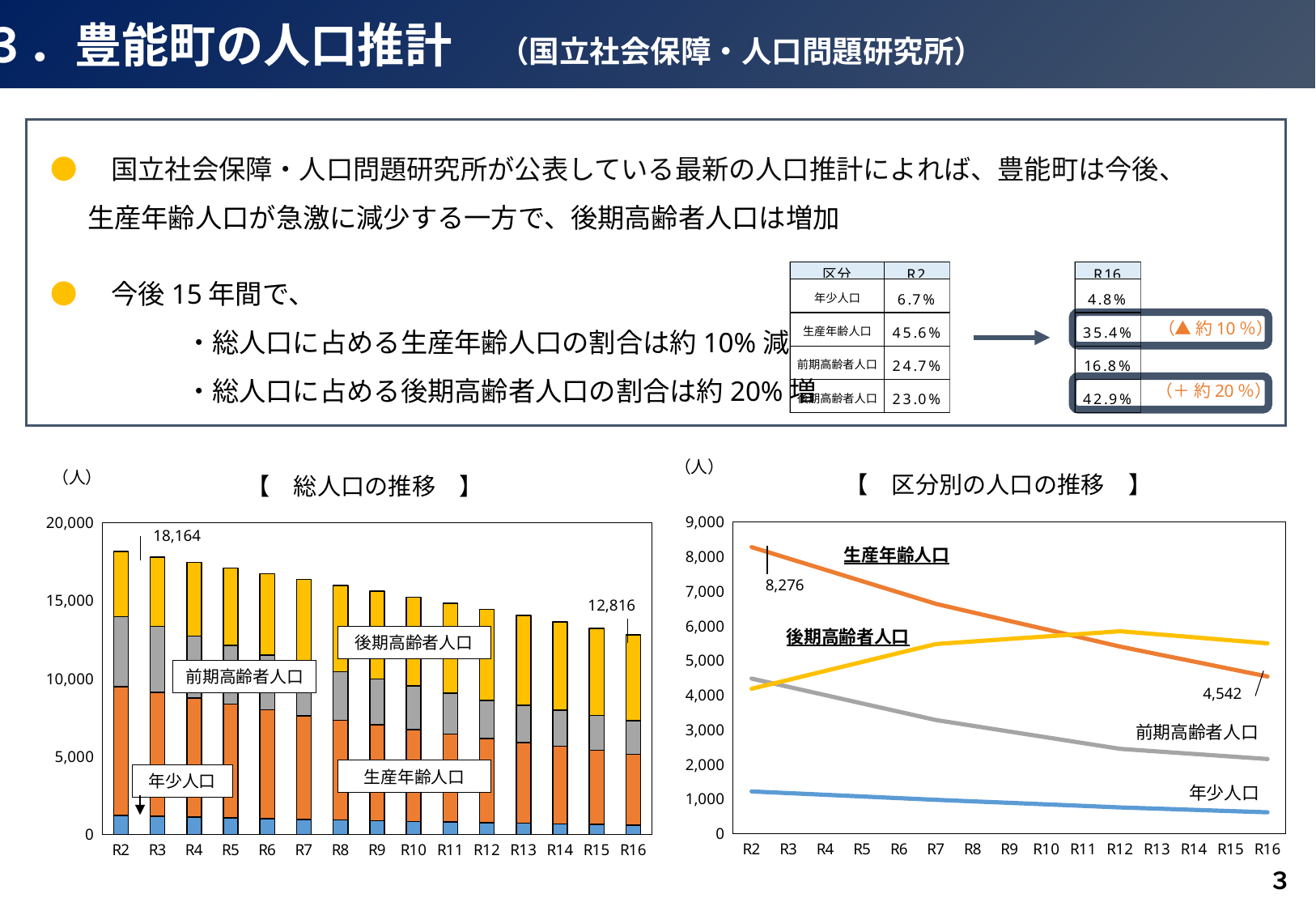
In the 区分別の人口の推移 chart, what is the value of 生産年齢人口 in R16? 4,542 In the 総人口の推移 chart, by how much does the total population fall from R2 to R16? 5,348 In the 区分別の人口の推移 chart, which is larger in R16: 後期高齢者人口 or 生産年齢人口? 後期高齢者人口 In the 総人口の推移 chart, what is the total population shown for R16? 12,816 In the 総人口の推移 chart, what is the total population shown for R2? 18,164 In the 区分別の人口の推移 chart, which category has the highest value in R2? 生産年齢人口 What kind of chart is the 区分別の人口の推移 chart on the right? line chart In the 総人口の推移 chart, is the total for R16 greater or less than 15,000? less In the 総人口の推移 chart, does the total population rise or fall from R2 to R16? fall In the 区分別の人口の推移 chart, what is the value of 生産年齢人口 in R2? 8,276 In the 総人口の推移 chart, how many years (categories) are plotted on the x axis? 15 What kind of chart is the 総人口の推移 chart on the left? stacked bar chart